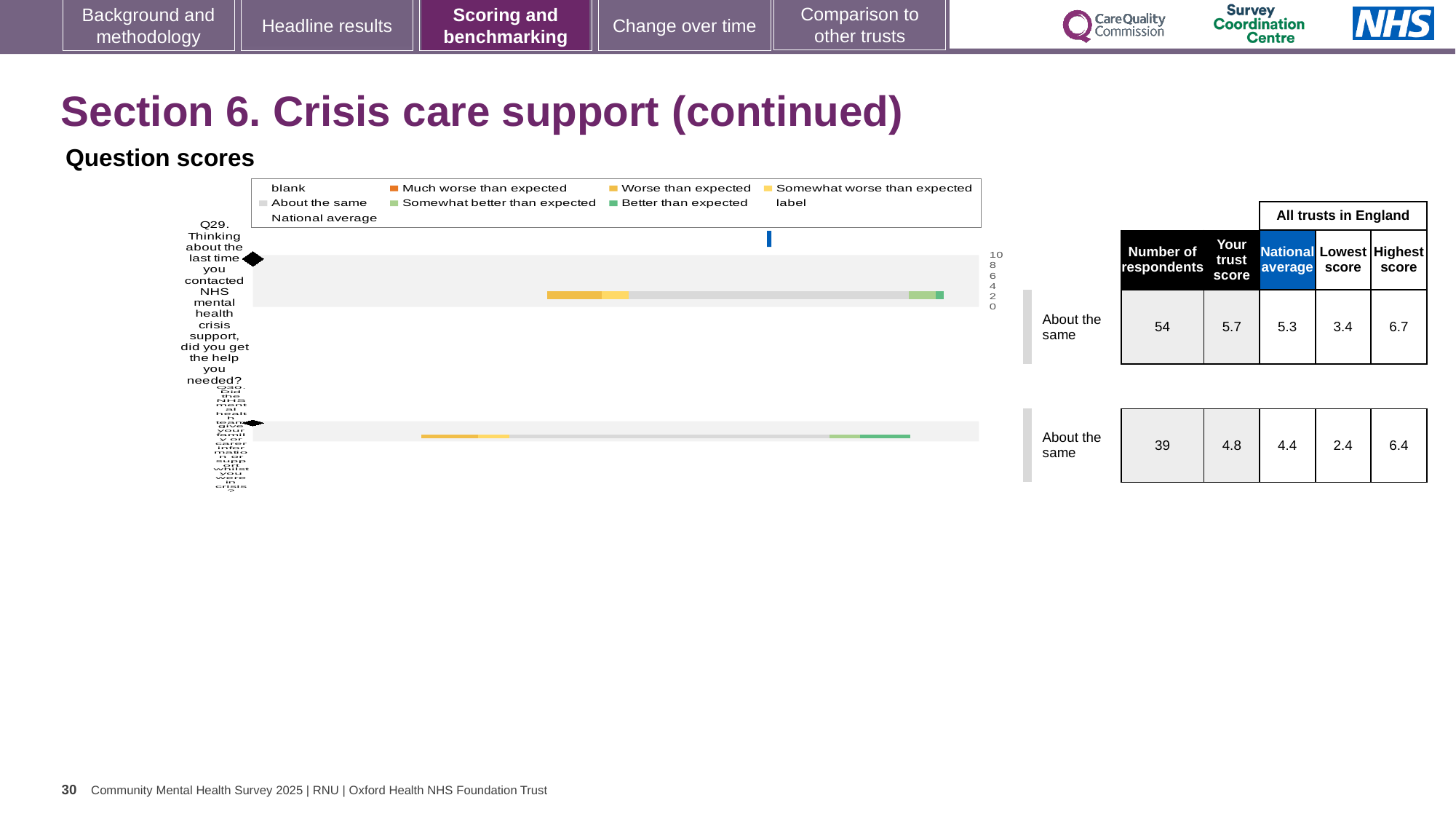
How many survey questions are plotted in the question scores chart? 2 What is the trust score for the second question (Q30)? 4.8 What is the highest score among all trusts in England for Q29? 6.7 What benchmark category is shown for both Q29 and Q30? About the same What is the highest value shown on the chart's score axis? 10 By how much does the trust score for Q29 exceed the national average for Q29? 0.4 How many respondents answered Q29? 54 What is the national average score for Q29? 5.3 What is the lowest score among all trusts in England for the second question (Q30)? 2.4 Which has the higher trust score, Q29 or Q30? Q29 What is the trust score for Q29 (did you get the help you needed when you contacted NHS mental health crisis support)? 5.7 What kind of chart is used to show the question scores on this slide? bar chart